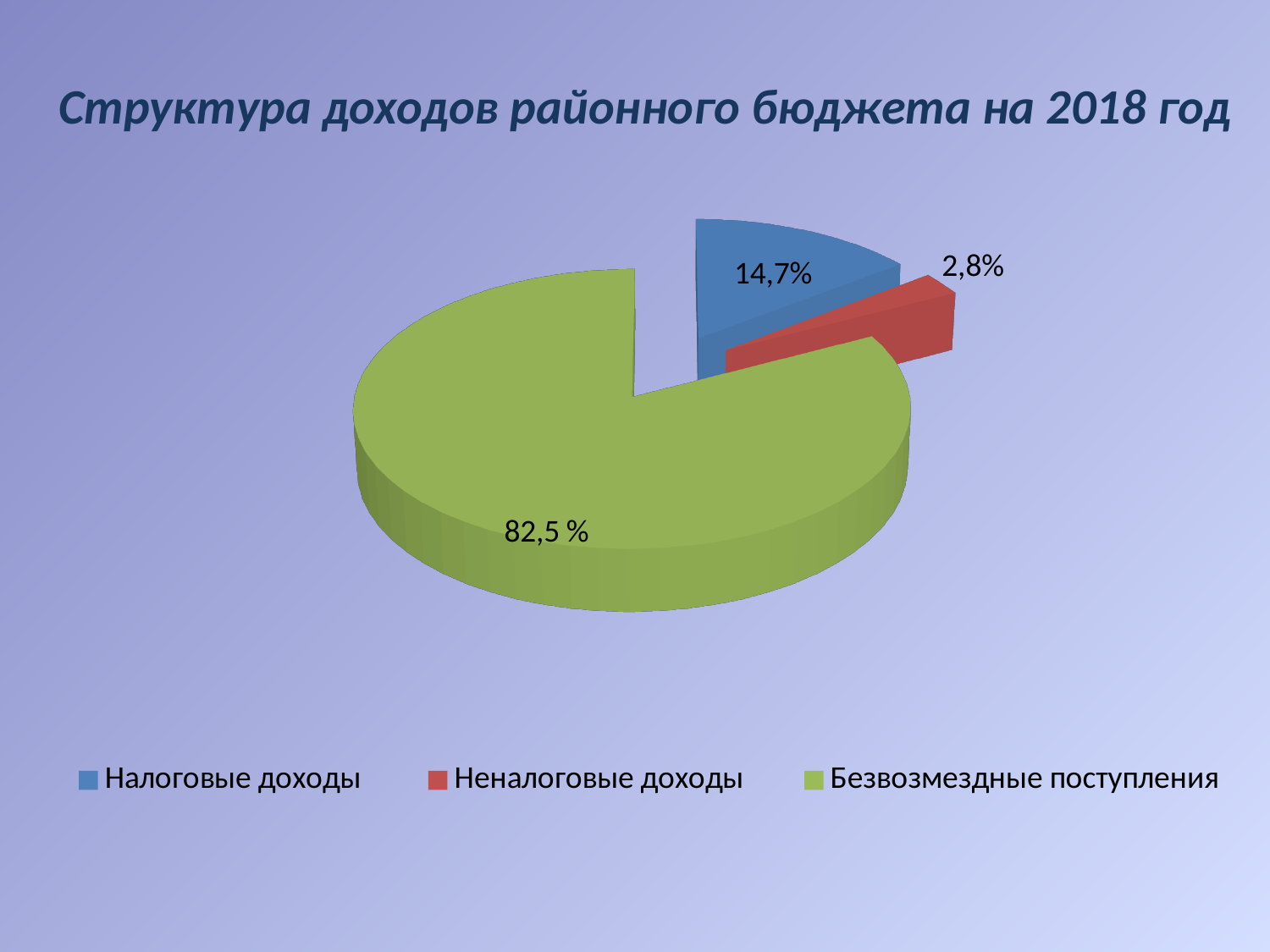
What is the difference in percentage points between the Налоговые доходы slice and the Неналоговые доходы slice? 11,9 Which is larger, the slice for Налоговые доходы or the slice for Неналоговые доходы? Налоговые доходы What share of the pie is labelled for Безвозмездные поступления? 82,5 % How many entries does the legend list? 3 How many slices does the pie chart have? 3 What kind of chart is shown on the slide? Pie chart Which category has the largest slice of the pie? Безвозмездные поступления What share of the pie is labelled for Неналоговые доходы? 2,8% What colour is the slice for Безвозмездные поступления? Green What is the title of the chart? Структура доходов районного бюджета на 2018 год What share of the pie is labelled for Налоговые доходы? 14,7% Which category has the smallest slice of the pie? Неналоговые доходы